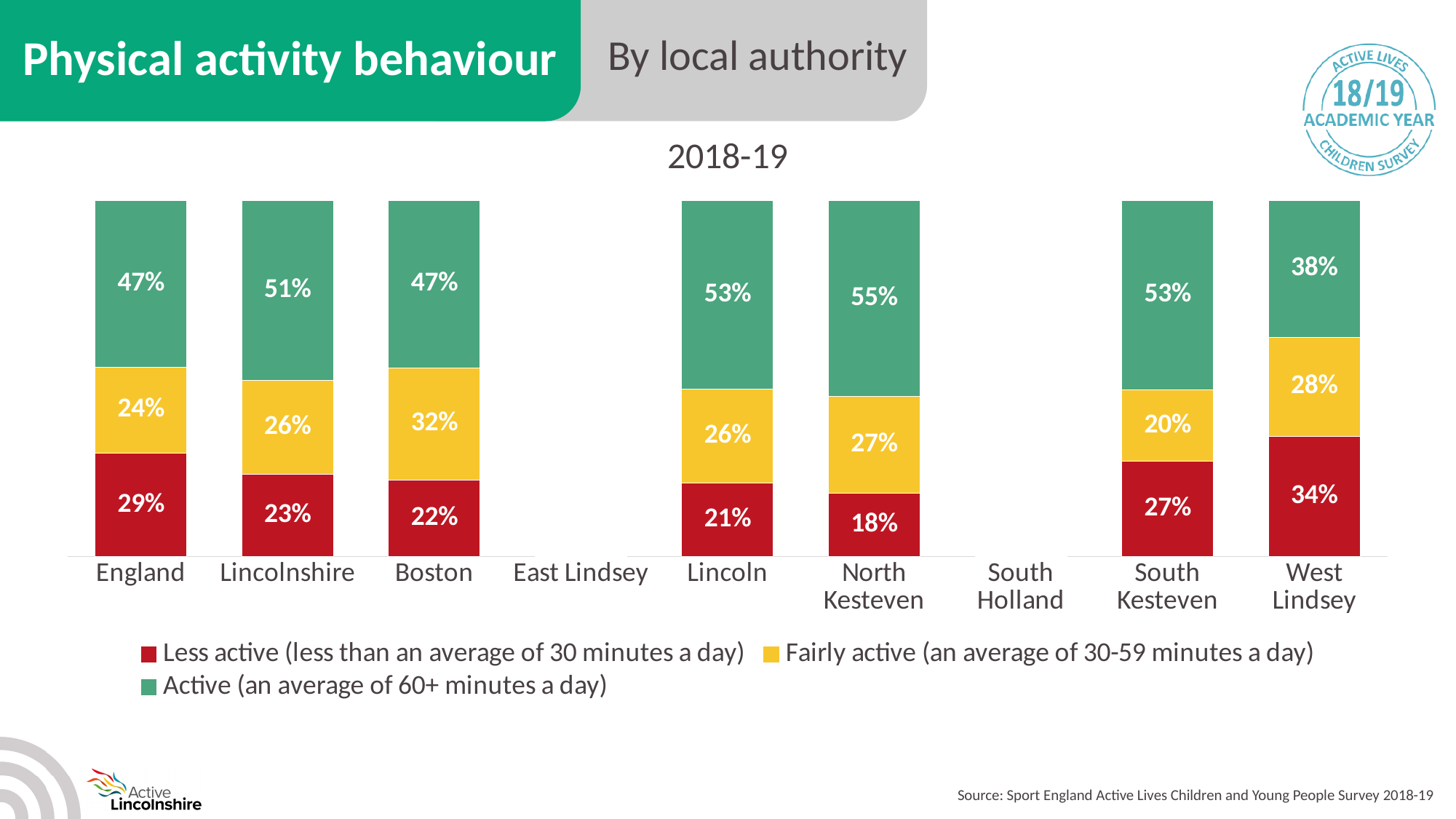
Which two local authorities on the x axis have no bars plotted? East Lindsey and South Holland Which has a larger 'Less active' value, England or Lincoln? England Which category has the highest 'Less active (less than an average of 30 minutes a day)' value? West Lindsey What is the total of the stacked bar for West Lindsey? 100% Which local authority has the highest 'Active (an average of 60+ minutes a day)' value? North Kesteven What kind of chart is shown on the slide? Stacked bar chart What is the 'Less active (less than an average of 30 minutes a day)' value for North Kesteven? 18% How many series does the legend list? 3 What is the difference between the 'Active' values for North Kesteven and England? 8% What is the 'Active (an average of 60+ minutes a day)' value for Lincolnshire? 51% What is the 'Fairly active (an average of 30-59 minutes a day)' value for Boston? 32%